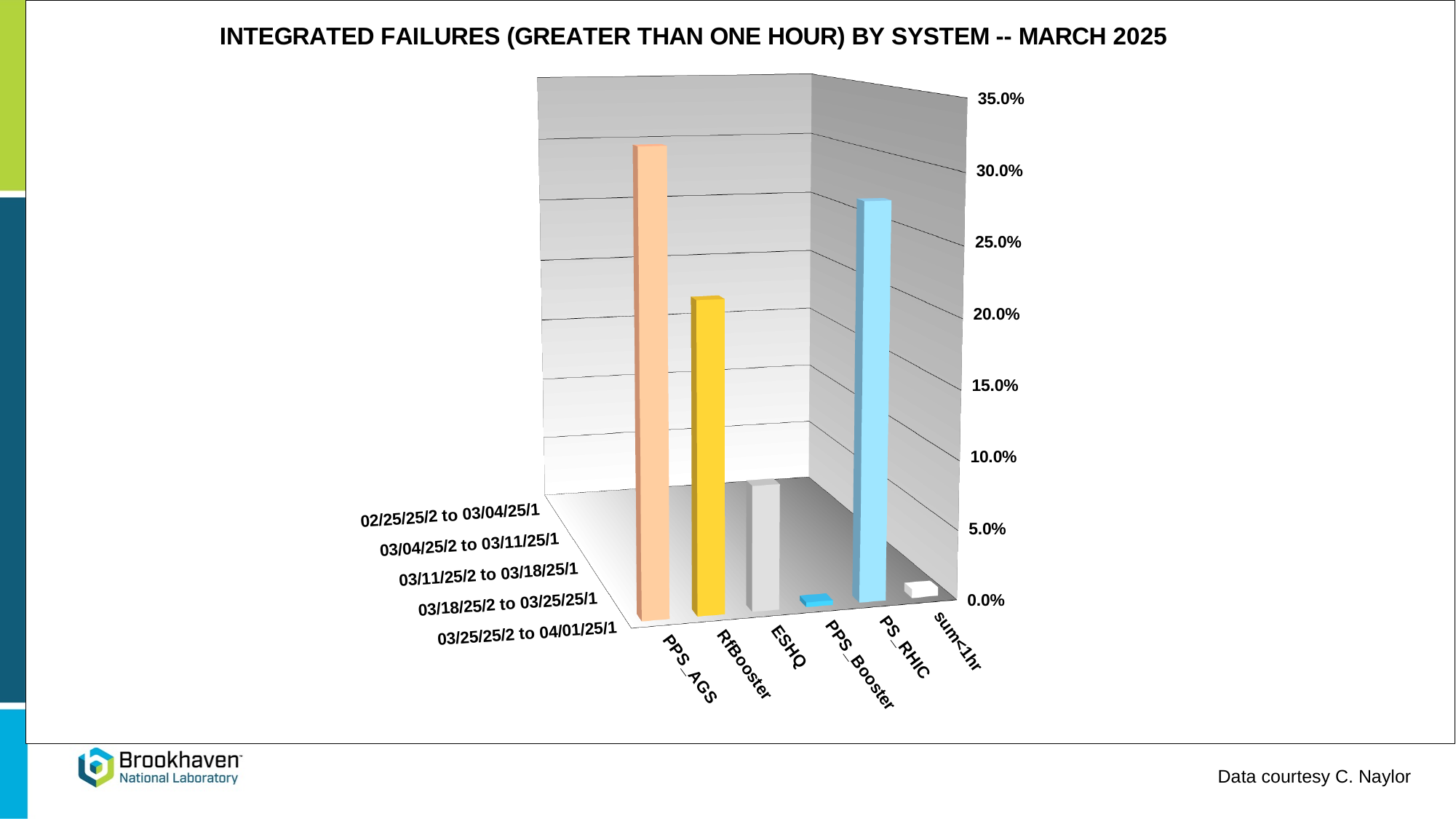
Is the value for PPS_Booster greater or less than 5.0%? less How many system categories are shown along the horizontal axis of the chart? 6 What is the title of the chart? INTEGRATED FAILURES (GREATER THAN ONE HOUR) BY SYSTEM -- MARCH 2025 Which system has the tallest bar in the chart? PPS_AGS Which is larger, the value for RfBooster or the value for ESHQ? RfBooster Is the value for ESHQ greater or less than 15.0%? less Is the value for PS_RHIC greater or less than 20.0%? greater What is the highest value labelled on the vertical axis of the chart? 35.0% What kind of chart is shown on the slide? bar chart Which is larger, the value for PPS_AGS or the value for PS_RHIC? PPS_AGS